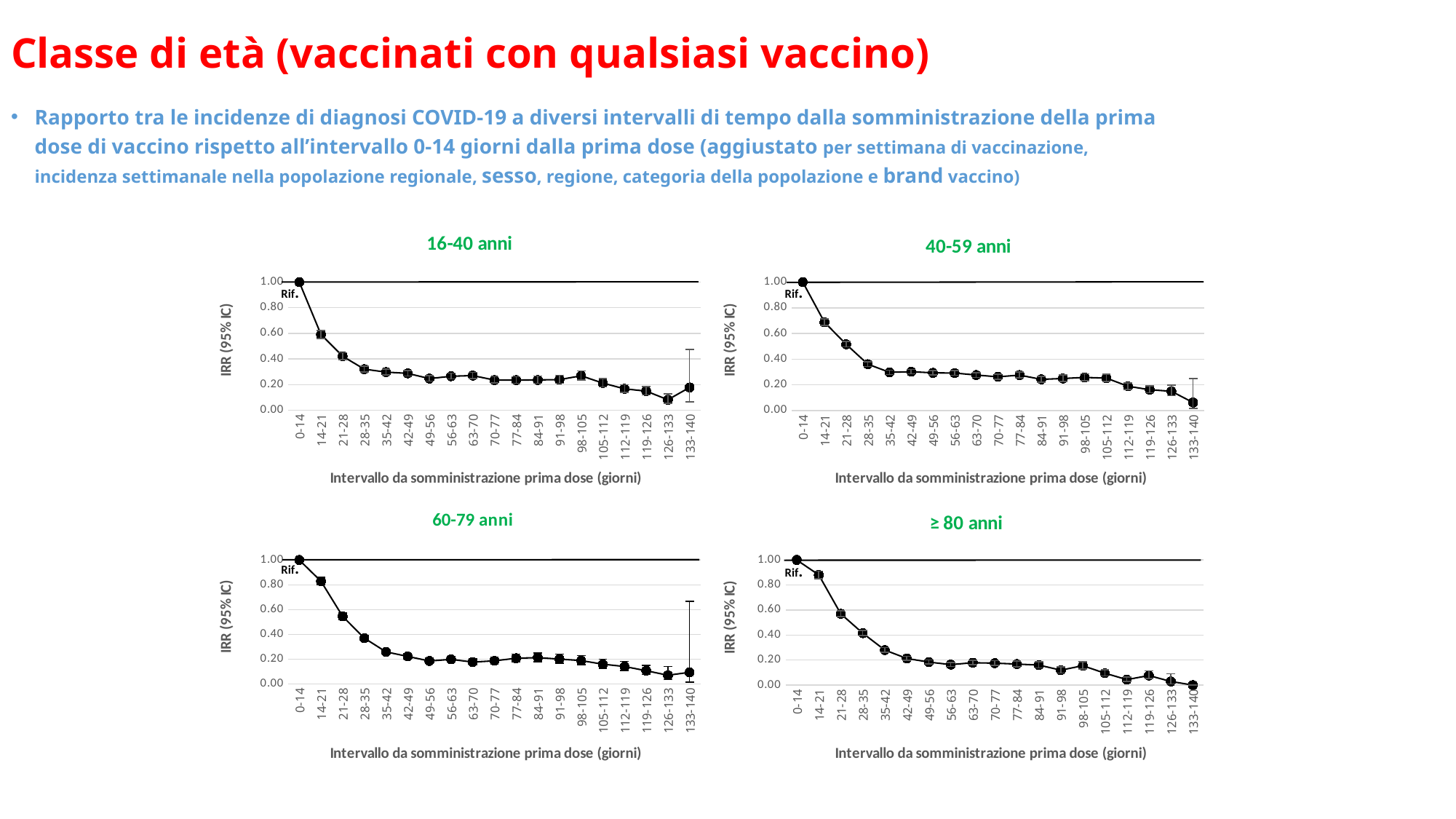
On the chart titled "16-40 anni", which interval has a higher IRR, 14-21 or 21-28? 14-21 On the chart titled "16-40 anni", which interval has the lowest IRR? 126-133 On the chart titled "16-40 anni", what is the IRR value for the 0-14 interval? 1.00 On the chart titled "≥ 80 anni", is the IRR for the 14-21 interval greater or less than 0.80? greater On the chart titled "40-59 anni", is the IRR for the 133-140 interval greater or less than 0.20? less On the chart titled "40-59 anni", which interval has the highest IRR? 0-14 What kind of chart is the one titled "≥ 80 anni"? Line chart On the chart titled "40-59 anni", do the IRR values generally rise or fall as the interval from the first dose increases? Fall On the chart titled "16-40 anni", is the IRR for the 14-21 interval greater or less than 0.40? greater How many intervals are shown on the x axis of the chart titled "60-79 anni"? 19 On the chart titled "≥ 80 anni", which interval has the lowest IRR? 133-140